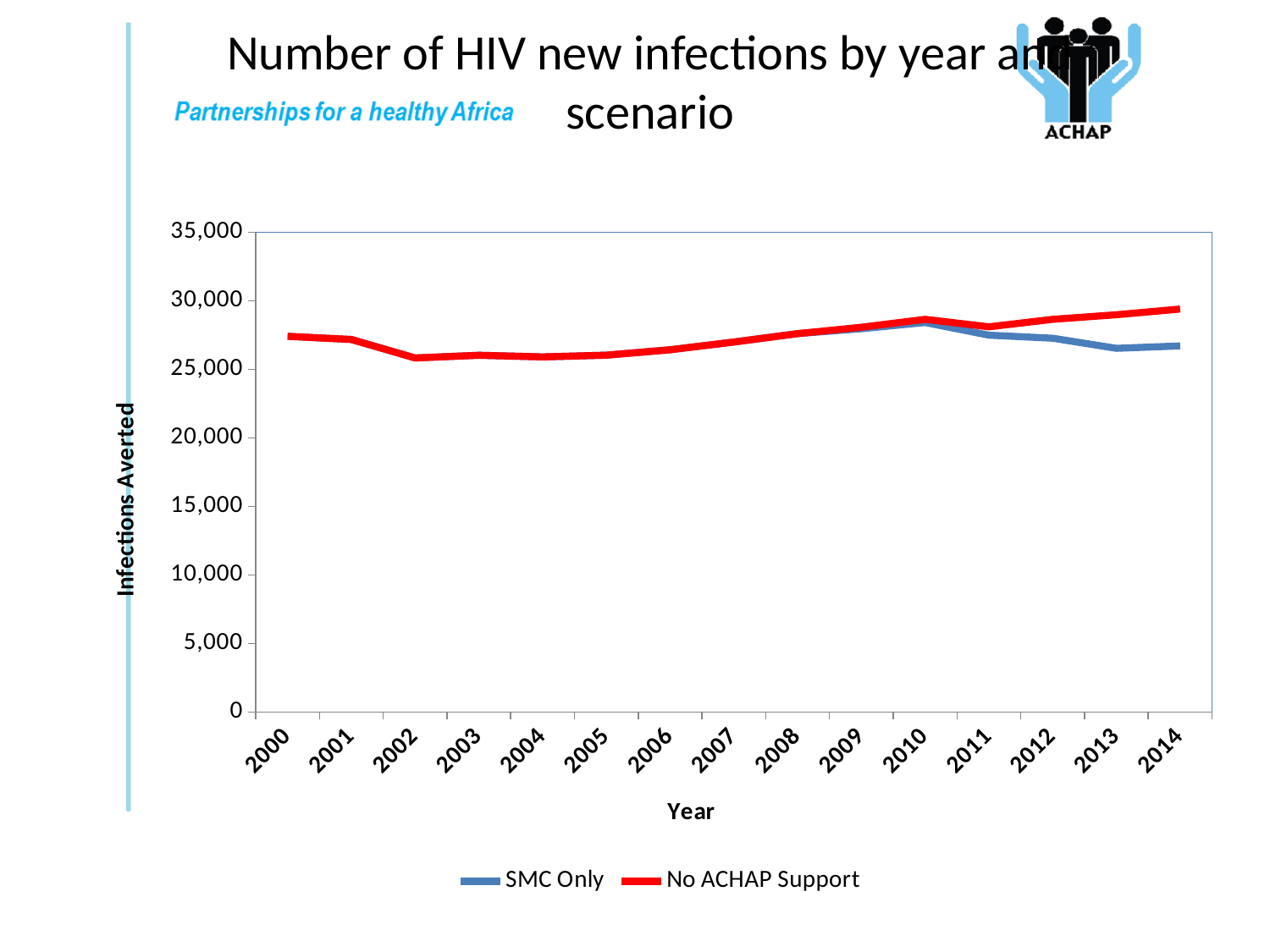
How many series does the legend list? 2 What is the title of the y axis? Infections Averted Does the SMC Only series rise or fall from 2010 to 2014? Fall Is the value for No ACHAP Support in 2002 greater or less than 30,000? less Does the No ACHAP Support series rise or fall from 2005 to 2014? Rise Is the value for SMC Only in 2014 greater or less than 30,000? less Is the value for No ACHAP Support in 2014 greater or less than 25,000? greater Which series is drawn in red? No ACHAP Support In which year does the No ACHAP Support series reach its highest value? 2014 How many years are plotted along the x axis? 15 In 2014, which series has the higher value, SMC Only or No ACHAP Support? No ACHAP Support What kind of chart is shown on the slide? Line chart